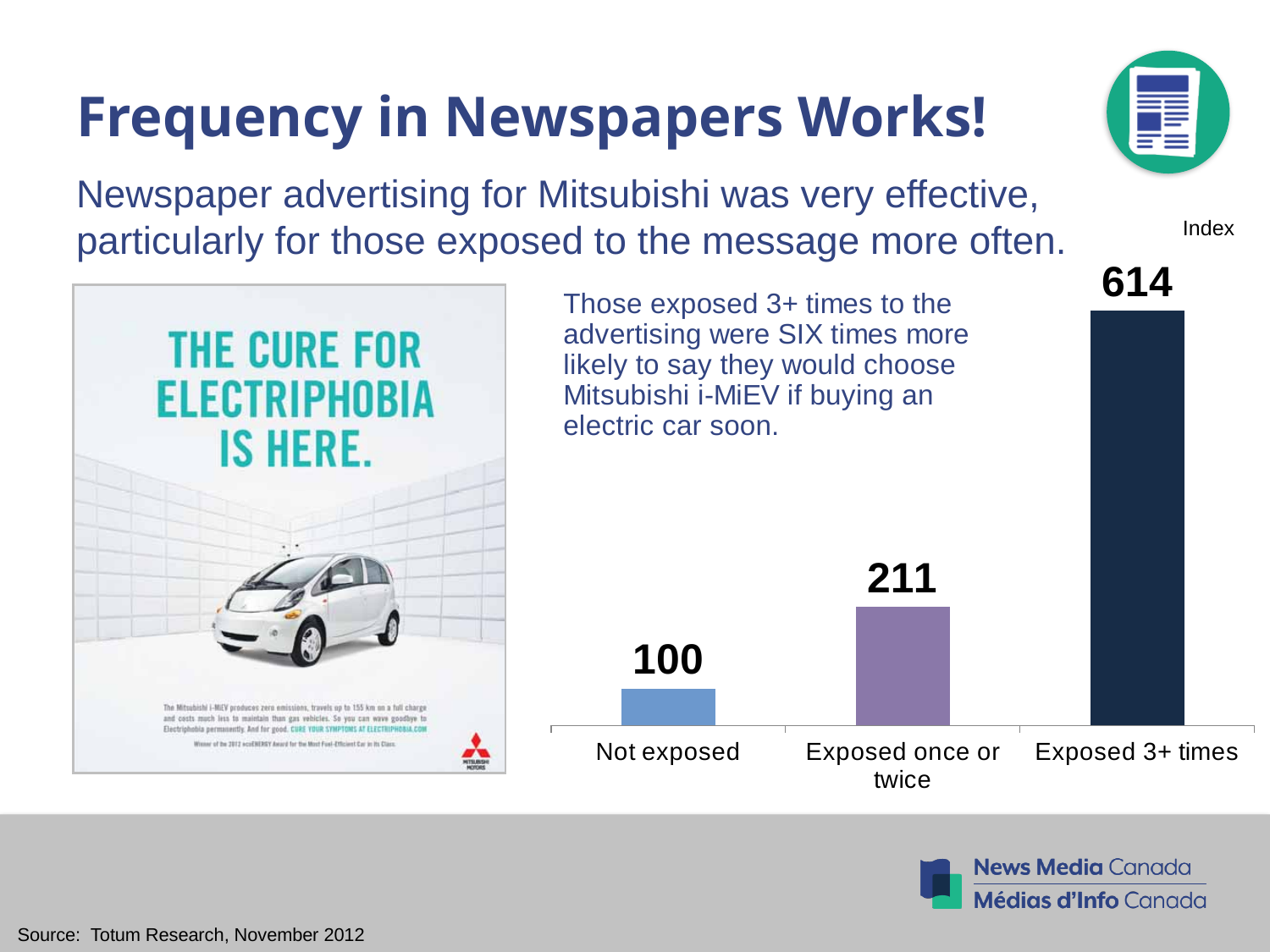
Which category has the highest index value? Exposed 3+ times What kind of chart is shown on the slide? Bar chart What is the index value for Exposed 3+ times? 614 How many categories are shown in the chart? 3 Do the index values rise or fall from Not exposed to Exposed 3+ times? Rise What is the difference between the index values for Exposed 3+ times and Not exposed? 514 Which is larger, the index value for Exposed once or twice or for Exposed 3+ times? Exposed 3+ times What is the index value for Exposed once or twice? 211 What is the index value for Not exposed? 100 Which category has the lowest index value? Not exposed What label appears above the chart indicating the measure plotted? Index What is the difference between the index values for Exposed once or twice and Not exposed? 111